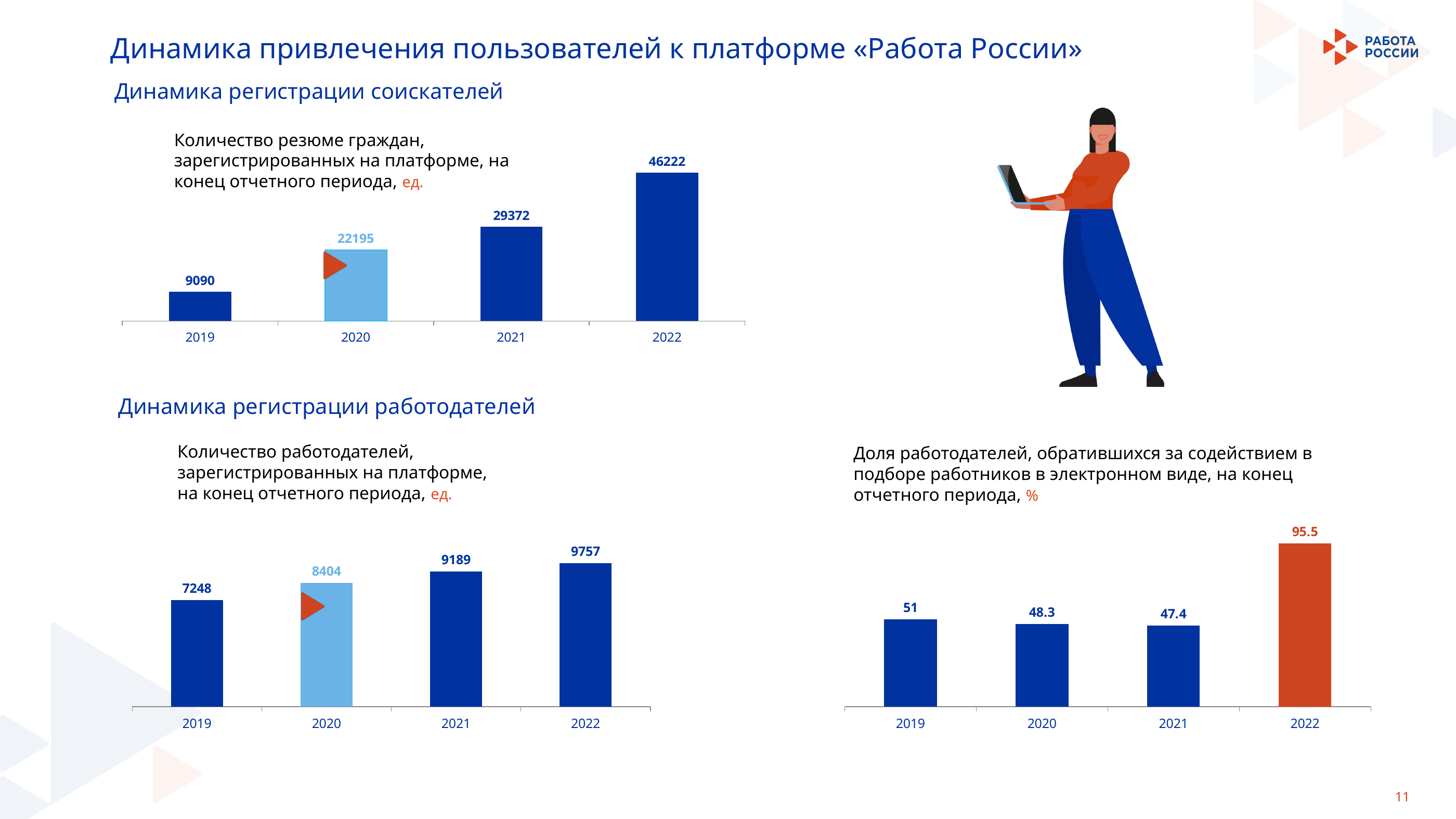
In the top-left chart (number of citizens' resumes registered on the platform), what is the value for 2022? 46222 In the bottom-right chart (share of employers who applied for recruitment assistance electronically, %), what is the value for 2021? 47.4 In the top-left chart (number of citizens' resumes registered on the platform), what is the value for 2020? 22195 In the bottom-right chart (share of employers, %), is the value for 2019 larger or the value for 2020? 2019 How many years (categories) are shown in the bottom-right chart (share of employers, %)? 4 In the bottom-right chart (share of employers, %), which year has the highest value? 2022 In the bottom-left chart (number of employers registered on the platform), which year has the highest value? 2022 In the top-left chart (number of citizens' resumes), do the values rise or fall from 2019 to 2022? rise In the bottom-left chart (number of employers), what is the difference between the 2020 and 2019 values? 1156 In the top-left chart (number of citizens' resumes), what is the difference between the 2022 and 2021 values? 16850 In the bottom-left chart (number of employers registered on the platform), what is the value for 2021? 9189 In the top-left chart (number of citizens' resumes), which year has the lowest value? 2019